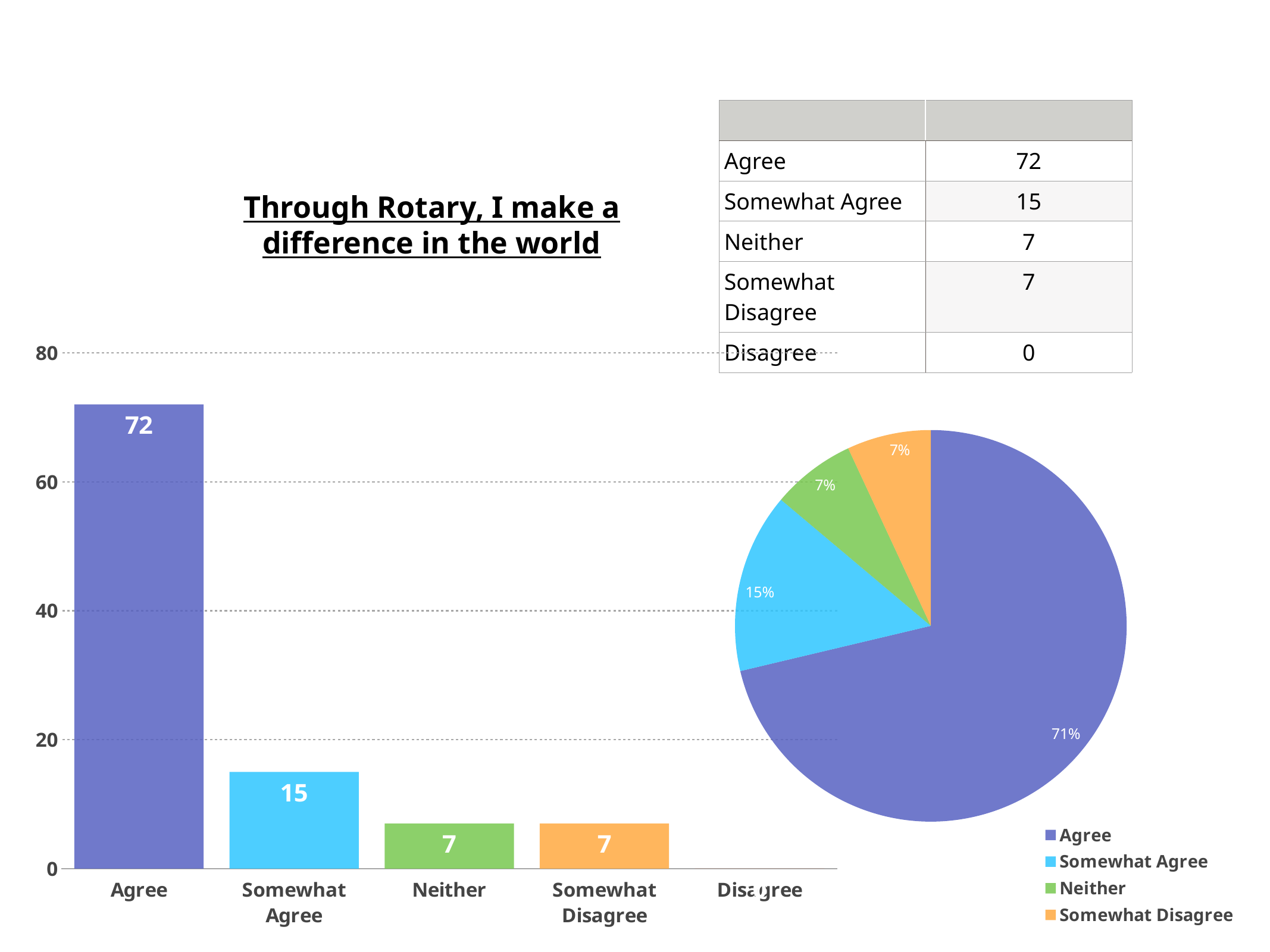
How many entries does the legend of the pie chart list? 4 What kind of chart is on the left side of the slide? bar chart In the bar chart, what is the difference between the values for Agree and Somewhat Agree? 57 In the bar chart, which is larger, the value for Somewhat Agree or the value for Neither? Somewhat Agree In the bar chart, what is the value for Agree? 72 In the bar chart, which category has the highest value? Agree In the bar chart, what is the value for Somewhat Agree? 15 In the bar chart, what is the value for Neither? 7 In the bar chart, is the value for Agree greater or less than 60? greater In the pie chart, what share does the Somewhat Agree slice have? 15% How many categories are shown on the x axis of the bar chart? 5 In the pie chart, what share does the Agree slice have? 71%